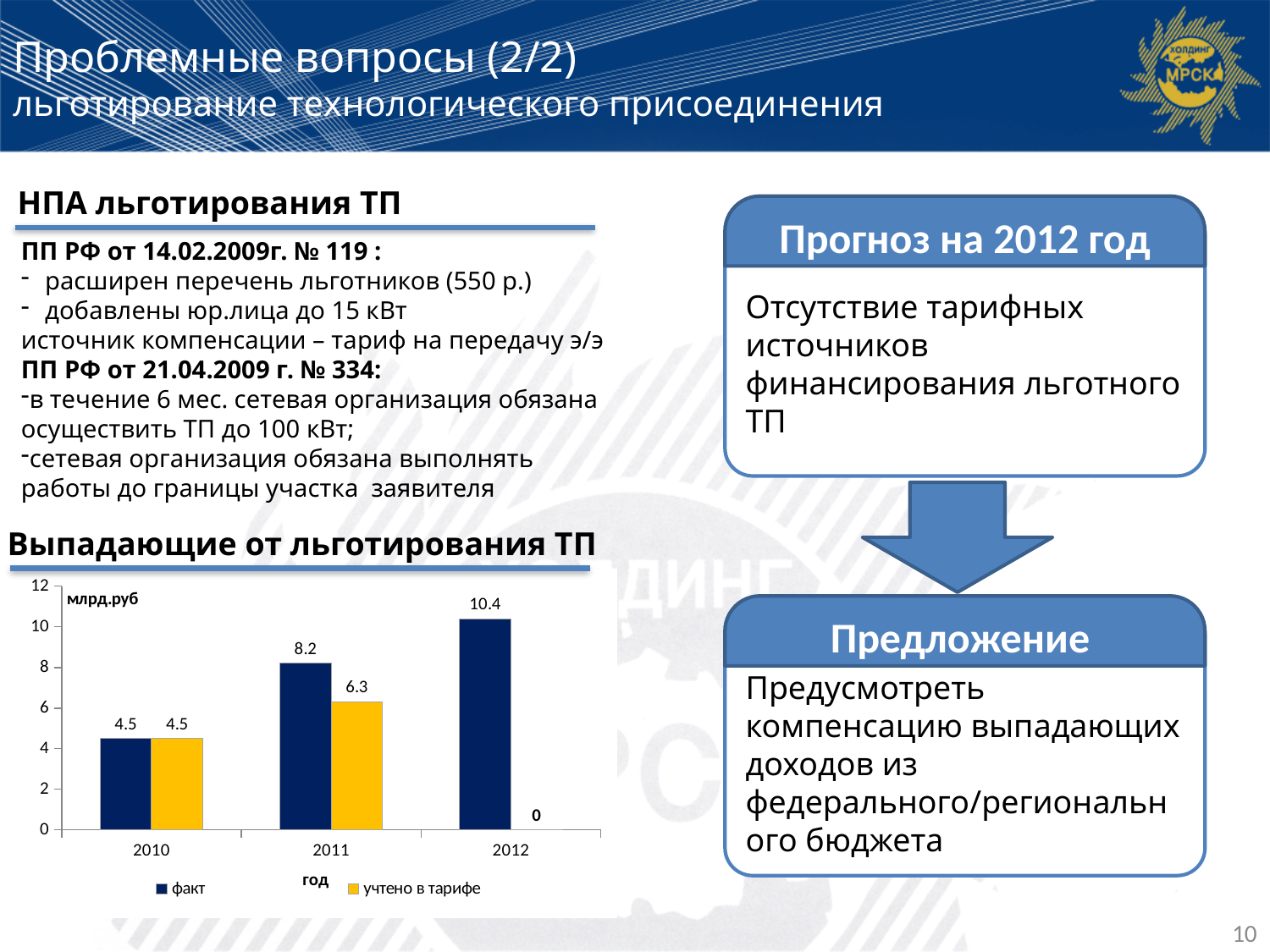
What type of chart is shown on the slide? bar chart What is the value of the "факт" series for 2012? 10.4 In which year is the "учтено в тарифе" value the lowest? 2012 What is the value of the "факт" series for 2011? 8.2 What is the difference between the "факт" and "учтено в тарифе" values for 2011? 1.9 Does the "факт" series rise or fall from 2010 to 2012? rise In which year is the "факт" value the highest? 2012 What is the value of the "учтено в тарифе" series for 2011? 6.3 How many series does the chart legend list? 2 How many years are shown on the x axis of the chart? 3 Which is larger for 2012: the "факт" value or the "учтено в тарифе" value? факт What is the value of the "учтено в тарифе" series for 2012? 0